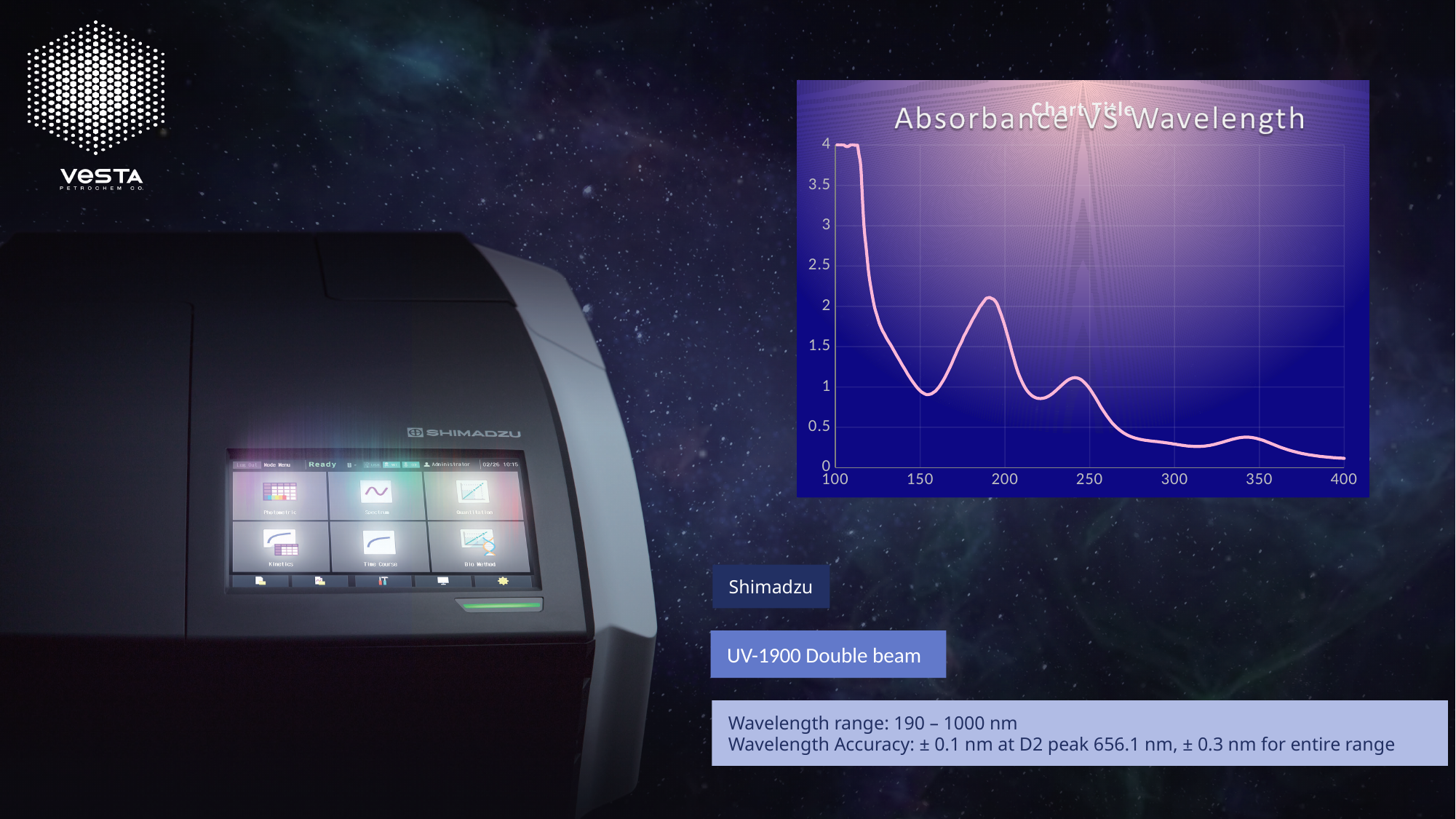
What is the maximum value shown on the vertical axis of the chart? 4 Is the absorbance at wavelength 350 greater or less than 1? less Is the absorbance at wavelength 400 greater or less than 0.5? less Is the absorbance at wavelength 100 larger or smaller than at wavelength 400? larger Is the absorbance at the peak near wavelength 190 greater or less than 1.5? greater What kind of chart is shown on the slide? line chart What is the title of the chart? Absorbance VS Wavelength Overall, does the absorbance rise or fall as wavelength increases from 100 to 400? fall At which end of the wavelength axis, 100 or 400, is the absorbance highest? 100 Between wavelengths 150 and 190, does the absorbance rise or fall? rise